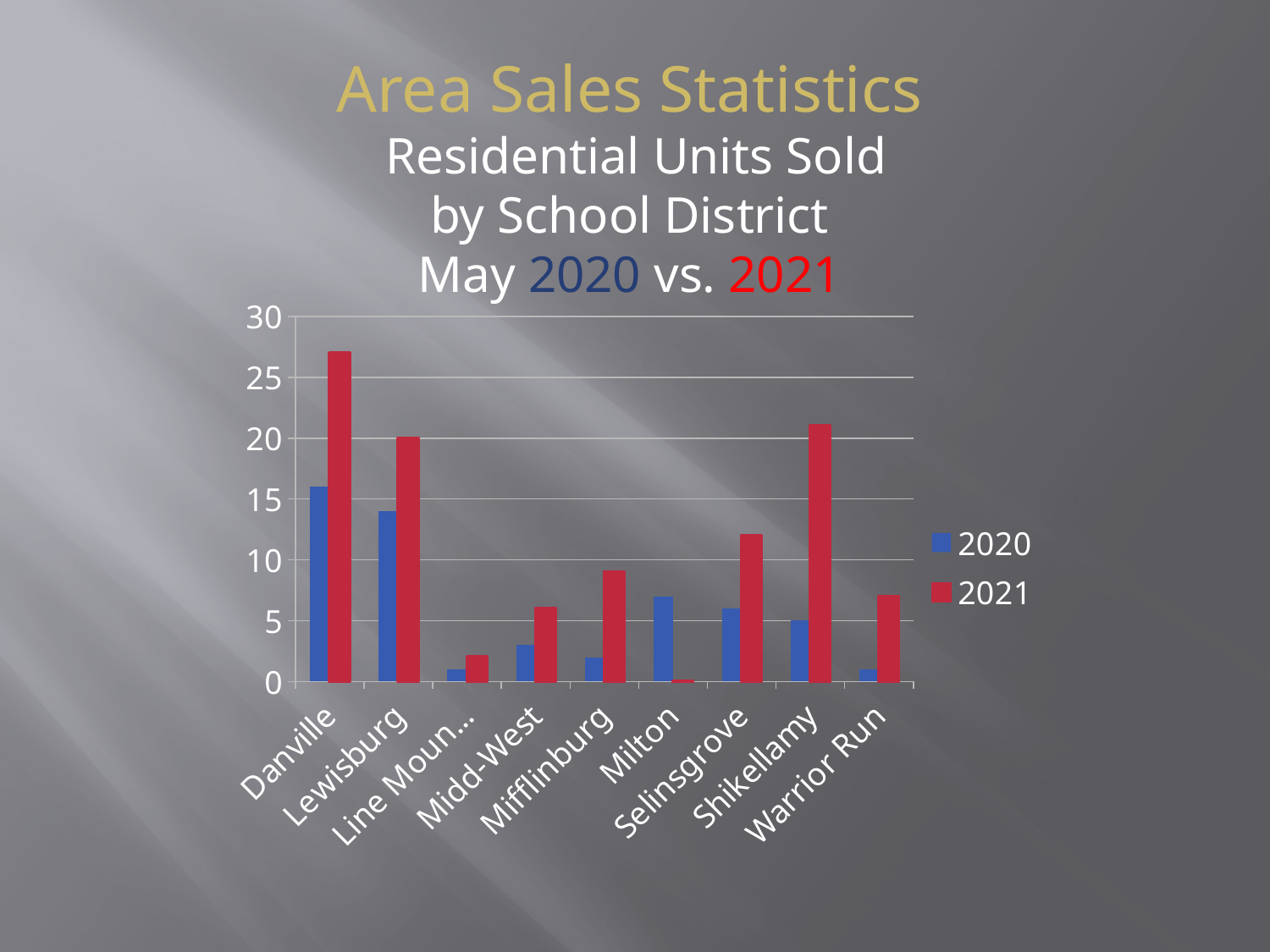
How many series does the legend list? 2 Is the 2021 value for Danville greater or less than 25? greater Which school district has the highest value for 2020? Danville Which colour represents the 2021 series in the legend? red For Milton, which is larger, the 2020 value or the 2021 value? 2020 Is the 2021 value for Shikellamy greater or less than 20? greater Which school district has the highest value for 2021? Danville For Selinsgrove, which is larger, the 2020 value or the 2021 value? 2021 What kind of chart is shown on the slide? bar chart How many school districts are shown on the x axis? 9 Is the 2020 value for Lewisburg greater or less than 15? less Which school district has the lowest value for 2021? Milton